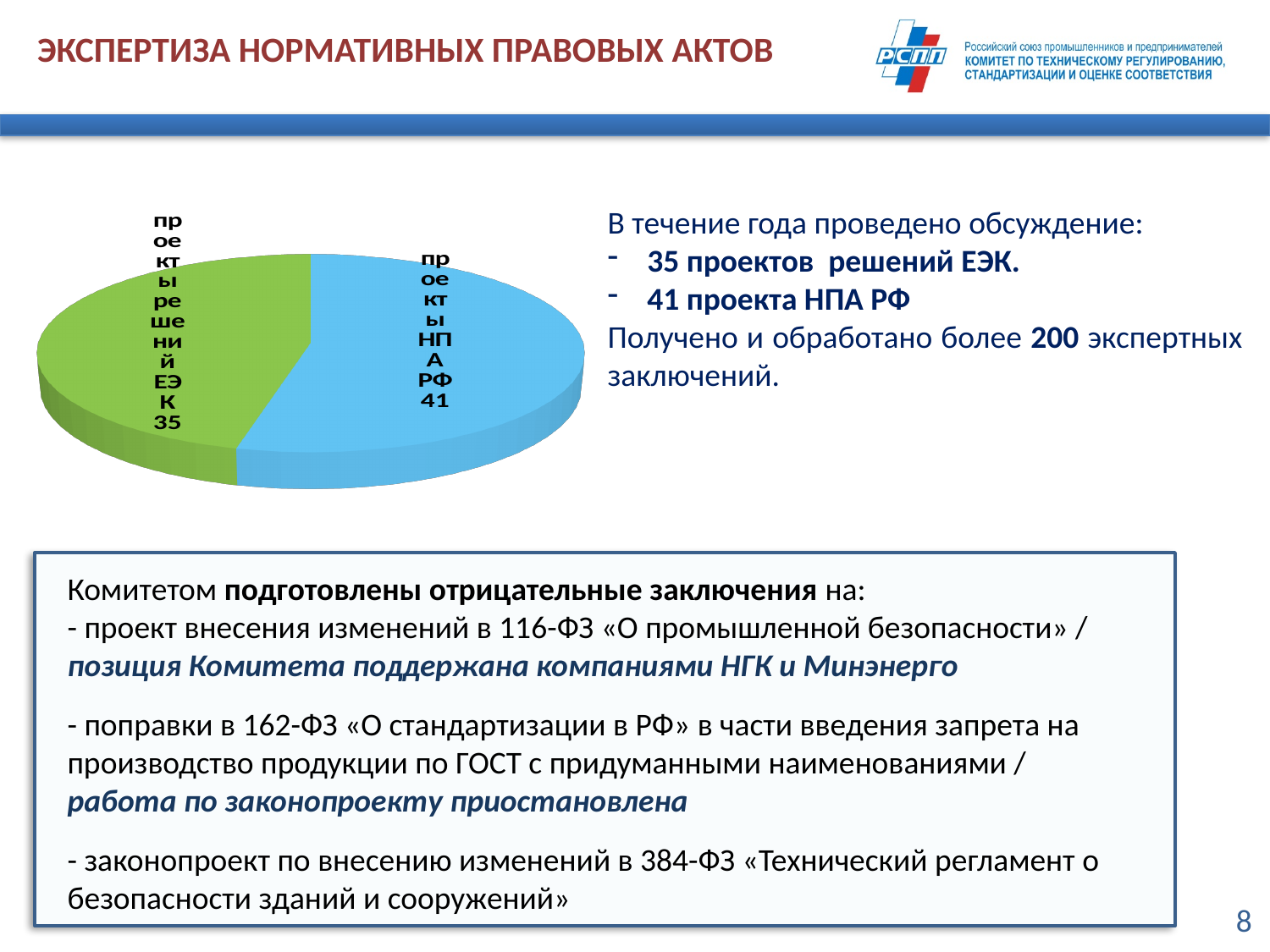
What colour is the "проекты решений ЕЭК" slice in the pie chart? green What is the value for "проекты НПА РФ" in the pie chart? 41 What is the value for "проекты решений ЕЭК" in the pie chart? 35 Which is larger: "проекты решений ЕЭК" or "проекты НПА РФ"? проекты НПА РФ Which slice of the pie chart is the smallest? проекты решений ЕЭК What colour is the "проекты НПА РФ" slice in the pie chart? blue Which slice of the pie chart is the largest? проекты НПА РФ What is the total of the two slices in the pie chart? 76 What kind of chart is shown on the slide? pie chart How many slices does the pie chart have? 2 What is the difference between the values for "проекты НПА РФ" and "проекты решений ЕЭК"? 6